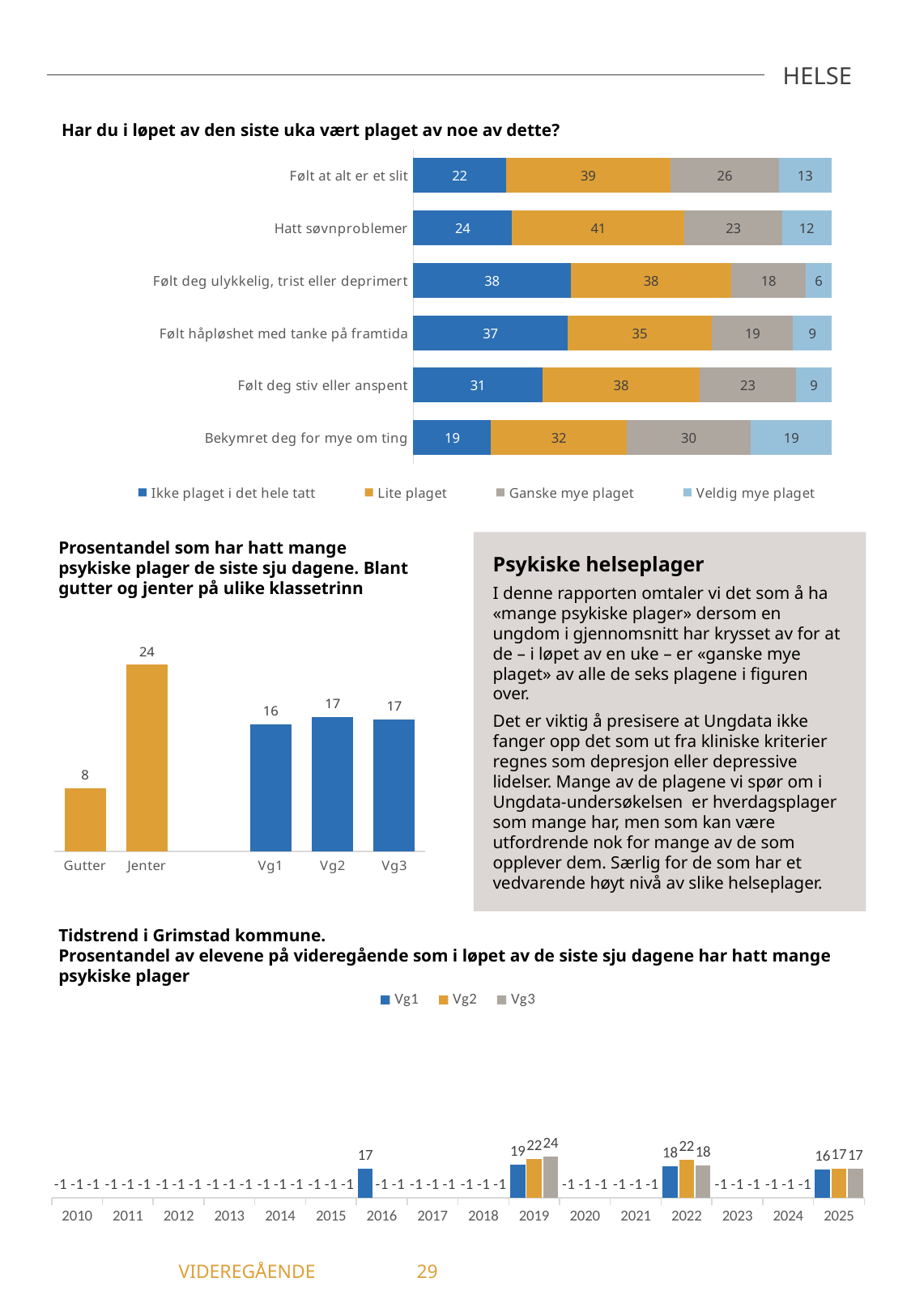
In the chart 'Har du i løpet av den siste uka vært plaget av noe av dette?', which category has the highest value for 'Veldig mye plaget'? Bekymret deg for mye om ting In the chart 'Prosentandel som har hatt mange psykiske plager de siste sju dagene', what is the difference between 'Jenter' and 'Gutter'? 16 In the chart 'Prosentandel som har hatt mange psykiske plager de siste sju dagene', which category has the lowest value? Gutter In the chart 'Tidstrend i Grimstad kommune', which is larger in 2022: Vg2 or Vg1? Vg2 In the chart 'Har du i løpet av den siste uka vært plaget av noe av dette?', how many series does the legend list? 4 What kind of chart is 'Har du i løpet av den siste uka vært plaget av noe av dette?'? Stacked bar chart In the chart 'Tidstrend i Grimstad kommune', what is the value for Vg1 in 2016? 17 In the chart 'Har du i løpet av den siste uka vært plaget av noe av dette?', how many categories are shown? 6 In the chart 'Tidstrend i Grimstad kommune', what is the value for Vg3 in 2019? 24 In the chart 'Prosentandel som har hatt mange psykiske plager de siste sju dagene', what is the value for 'Jenter'? 24 In the chart 'Har du i løpet av den siste uka vært plaget av noe av dette?', what is the value for 'Lite plaget' for 'Hatt søvnproblemer'? 41 In the chart 'Har du i løpet av den siste uka vært plaget av noe av dette?', what is the difference between 'Ikke plaget i det hele tatt' for 'Følt deg ulykkelig, trist eller deprimert' and for 'Følt at alt er et slit'? 16